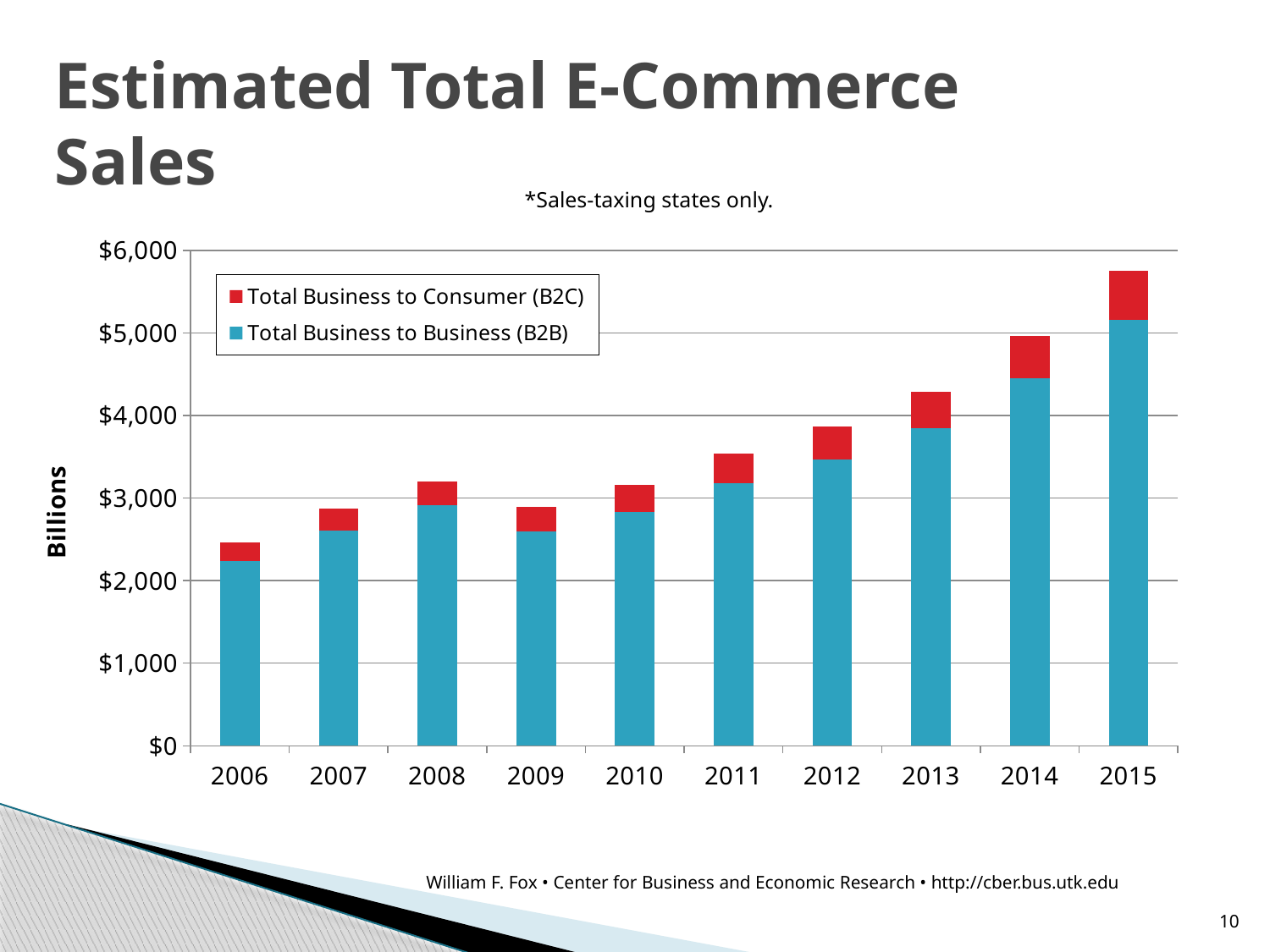
Which year has higher total e-commerce sales, 2008 or 2009? 2008 Which year has the lowest total e-commerce sales in the chart? 2006 Which series makes up the larger part of each bar, Total Business to Consumer (B2C) or Total Business to Business (B2B)? Total Business to Business (B2B) How many years are shown on the x axis of the chart? 10 What is the label on the vertical axis of the chart? Billions Is the Total Business to Business (B2B) value for 2014 greater or less than $5,000? less Is the total e-commerce sales value for 2013 greater or less than $4,000? greater Is the total e-commerce sales value for 2006 greater or less than $2,000? greater How many series does the chart's legend list? 2 Which year has the highest total e-commerce sales in the chart? 2015 What kind of chart is shown on the slide? Stacked bar chart